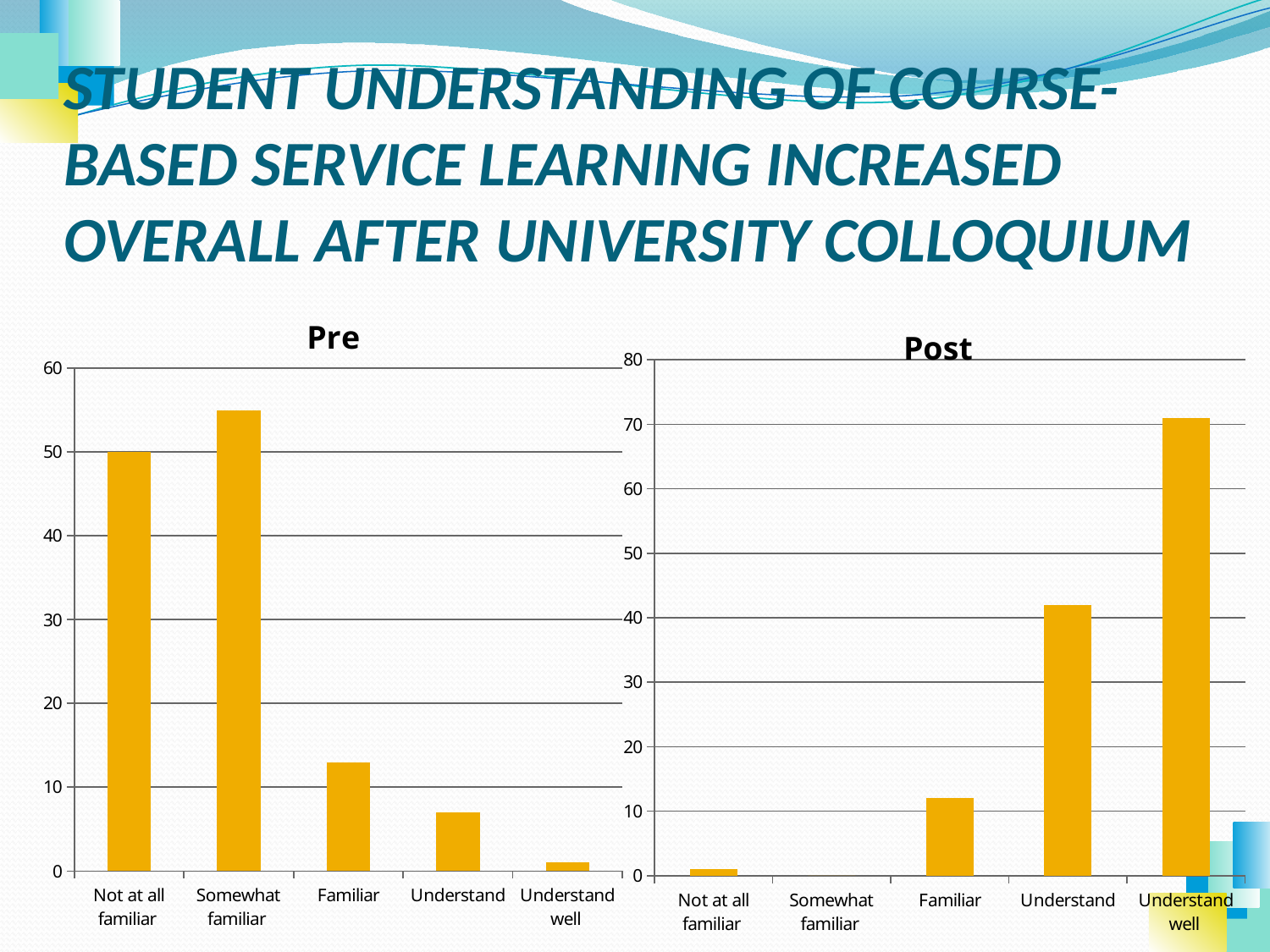
In the Pre chart, what is the value for Not at all familiar? 50 In the Pre chart, which category has the lowest bar? Understand well In the Pre chart, is the value for Familiar greater or less than 10? greater In the Post chart, which is larger, the value for Familiar or the value for Understand? Understand How many categories are shown on the x axis of the Post chart? 5 What is the title of the chart on the right side of the slide? Post In the Post chart, which category has the highest bar? Understand well In the Post chart, is the value for Understand greater or less than 50? less In the Pre chart, which category has the highest bar? Somewhat familiar In the Post chart, do the values generally rise or fall from left to right along the x axis? rise What kind of chart is the Pre chart? bar chart In the Post chart, is the value for Understand well greater or less than 60? greater